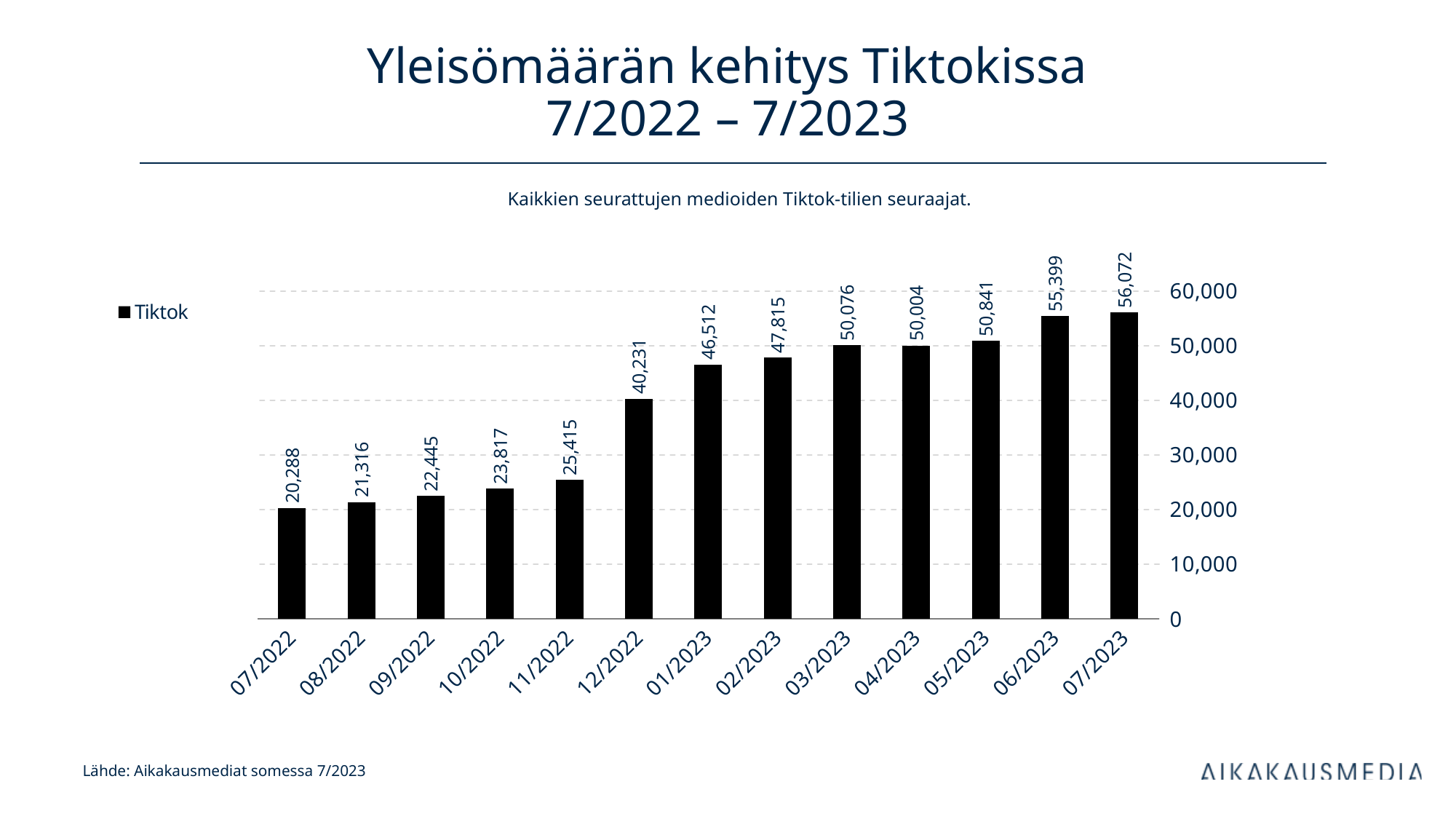
Which month has the lowest value? 07/2022 What kind of chart is shown on the slide? bar chart Is the value for 01/2023 greater or less than 40,000? greater What is the difference between the values for 12/2022 and 11/2022? 14,816 Which month has the highest value? 07/2023 How many months are shown on the x axis? 13 What is the value for 07/2022? 20,288 What is the value for 12/2022? 40,231 What is the value for 07/2023? 56,072 What is the difference between the values for 07/2023 and 07/2022? 35,784 Which is larger, the value for 05/2023 or the value for 06/2023? 06/2023 Do the values generally rise or fall from 07/2022 to 07/2023? rise